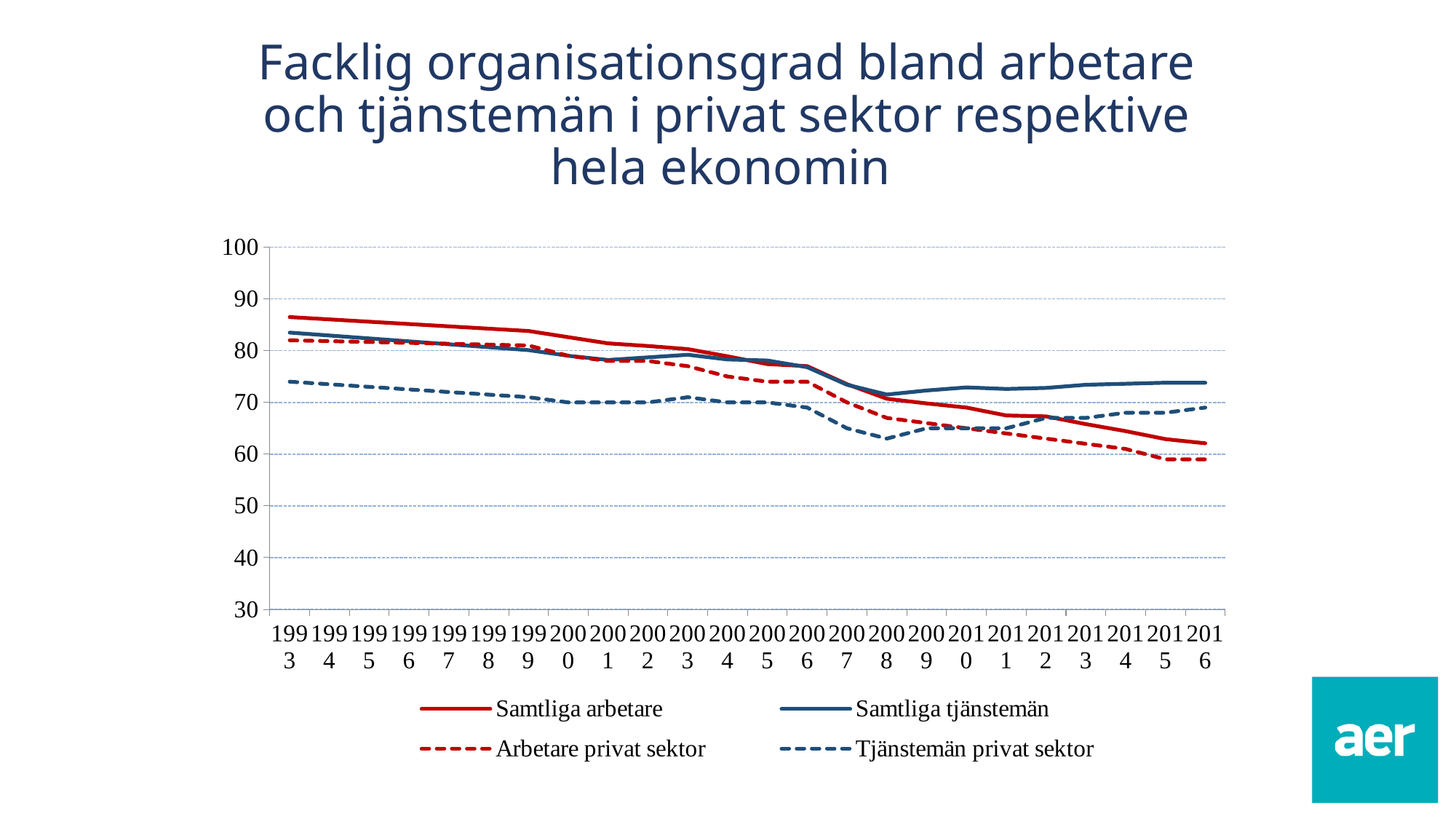
Is the value for Arbetare privat sektor in 2016 greater or less than 60? less What kind of chart is shown on the slide? line chart In 2016, which is higher: Samtliga arbetare or Samtliga tjänstemän? Samtliga tjänstemän Does the value for Samtliga arbetare rise or fall from 1993 to 2016? fall How many years are shown along the x axis? 24 Is the value for Samtliga arbetare in 1993 greater or less than 80? greater How many series does the legend list? 4 Which series is plotted as a solid red line? Samtliga arbetare Is the value for Tjänstemän privat sektor in 2008 greater or less than 70? less What is the first year shown on the x axis? 1993 Which series has the lowest value in 2016? Arbetare privat sektor